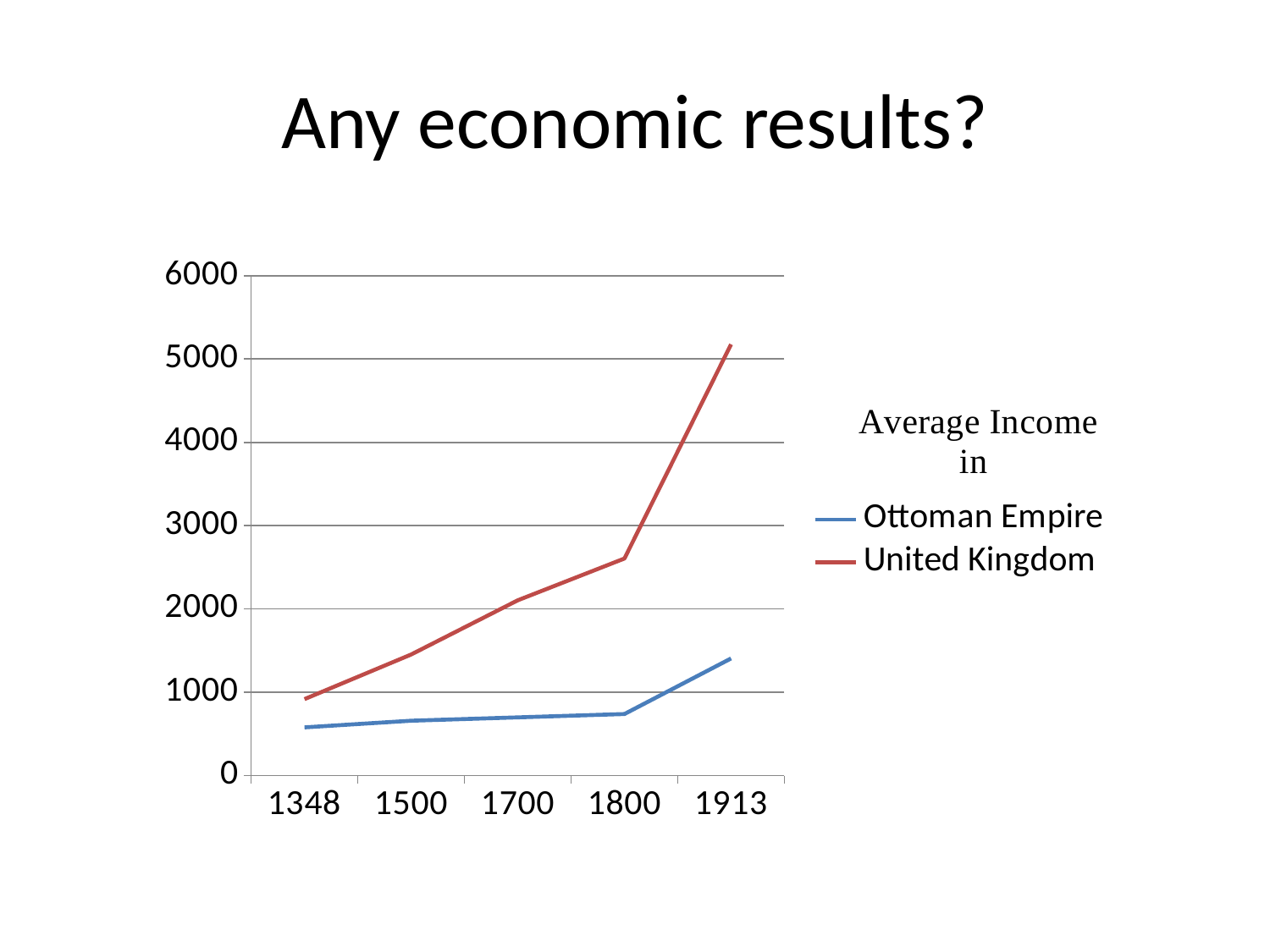
In which year is the Ottoman Empire's value lowest? 1348 In which year is the United Kingdom's value highest? 1913 Is the value for the Ottoman Empire in 1800 greater or less than 1000? less Is the value for the United Kingdom in 1800 greater or less than 2000? greater How many years are shown on the x axis? 5 Which series has the higher value in 1913, Ottoman Empire or United Kingdom? United Kingdom Is the value for the United Kingdom in 1913 greater or less than 4000? greater How many series does the legend list? 2 Do the United Kingdom's values rise or fall from 1348 to 1913? rise What kind of chart is shown on the slide? line chart What colour is the line for the United Kingdom? red